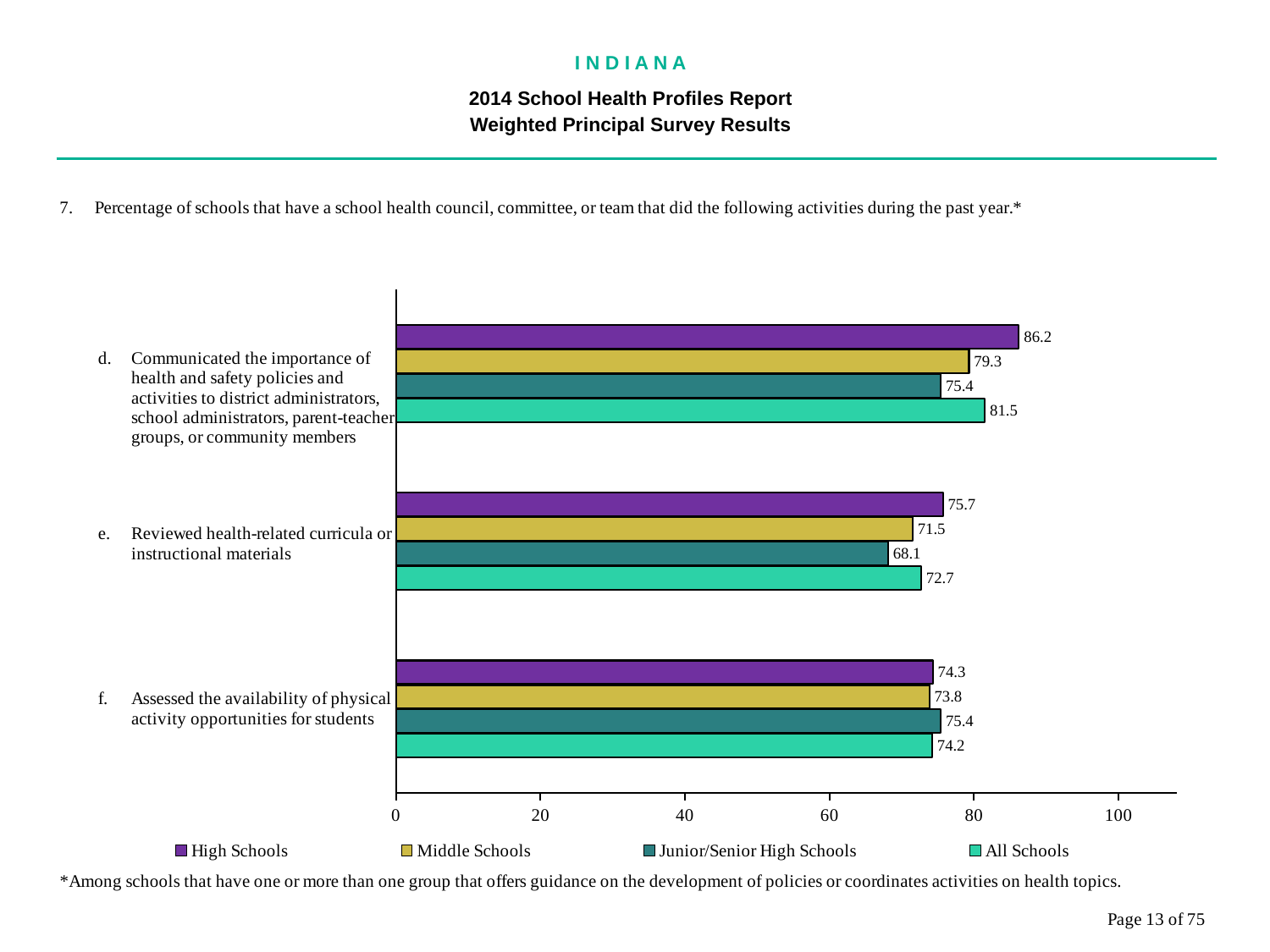
Is the High Schools value for activity d (Communicated the importance of health and safety policies and activities) greater or less than 80? greater For activity f (Assessed the availability of physical activity opportunities for students), which is larger: the Middle Schools value or the Junior/Senior High Schools value? Junior/Senior High Schools What is the value for Junior/Senior High Schools for activity e (Reviewed health-related curricula or instructional materials)? 68.1 What is the value for High Schools for activity d (Communicated the importance of health and safety policies and activities)? 86.2 What is the difference between the All Schools and Junior/Senior High Schools values for activity e (Reviewed health-related curricula or instructional materials)? 4.6 Which school type has the lowest value for activity e (Reviewed health-related curricula or instructional materials)? Junior/Senior High Schools How many activities (categories) are shown on the chart? 3 What is the value for All Schools for activity f (Assessed the availability of physical activity opportunities for students)? 74.2 Which school type has the highest value for activity d (Communicated the importance of health and safety policies and activities)? High Schools How many series does the legend list? 4 What is the difference between the High Schools and Middle Schools values for activity d (Communicated the importance of health and safety policies and activities)? 6.9 What kind of chart is shown on the slide? Bar chart